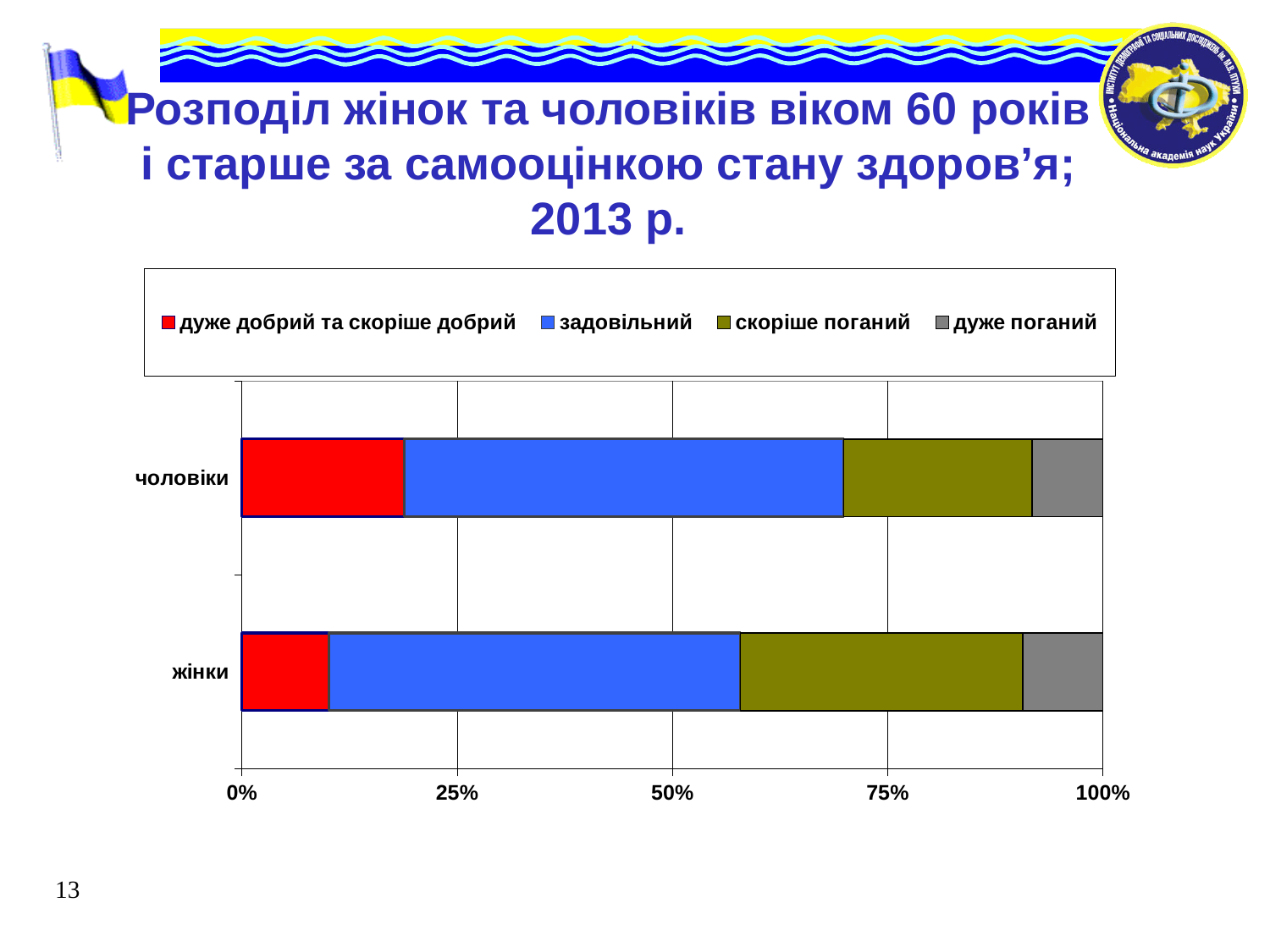
Is the value of дуже добрий та скоріше добрий for чоловіки greater or less than 25%? less Which category has the larger share of скоріше поганий, чоловіки or жінки? жінки How many categories are plotted on the vertical axis? 2 How many series does the legend list? 4 What colour represents the series задовільний in the legend? blue Which series has the smallest segment in the bar for чоловіки? дуже поганий Which series has the largest segment in the bar for жінки? задовільний Which series has the largest segment in the bar for чоловіки? задовільний What kind of chart is shown on the slide? stacked bar chart Which category has the larger share of дуже добрий та скоріше добрий, чоловіки or жінки? чоловіки Is the value of скоріше поганий for жінки greater or less than 25%? greater Is the value of задовільний for чоловіки greater or less than 25%? greater